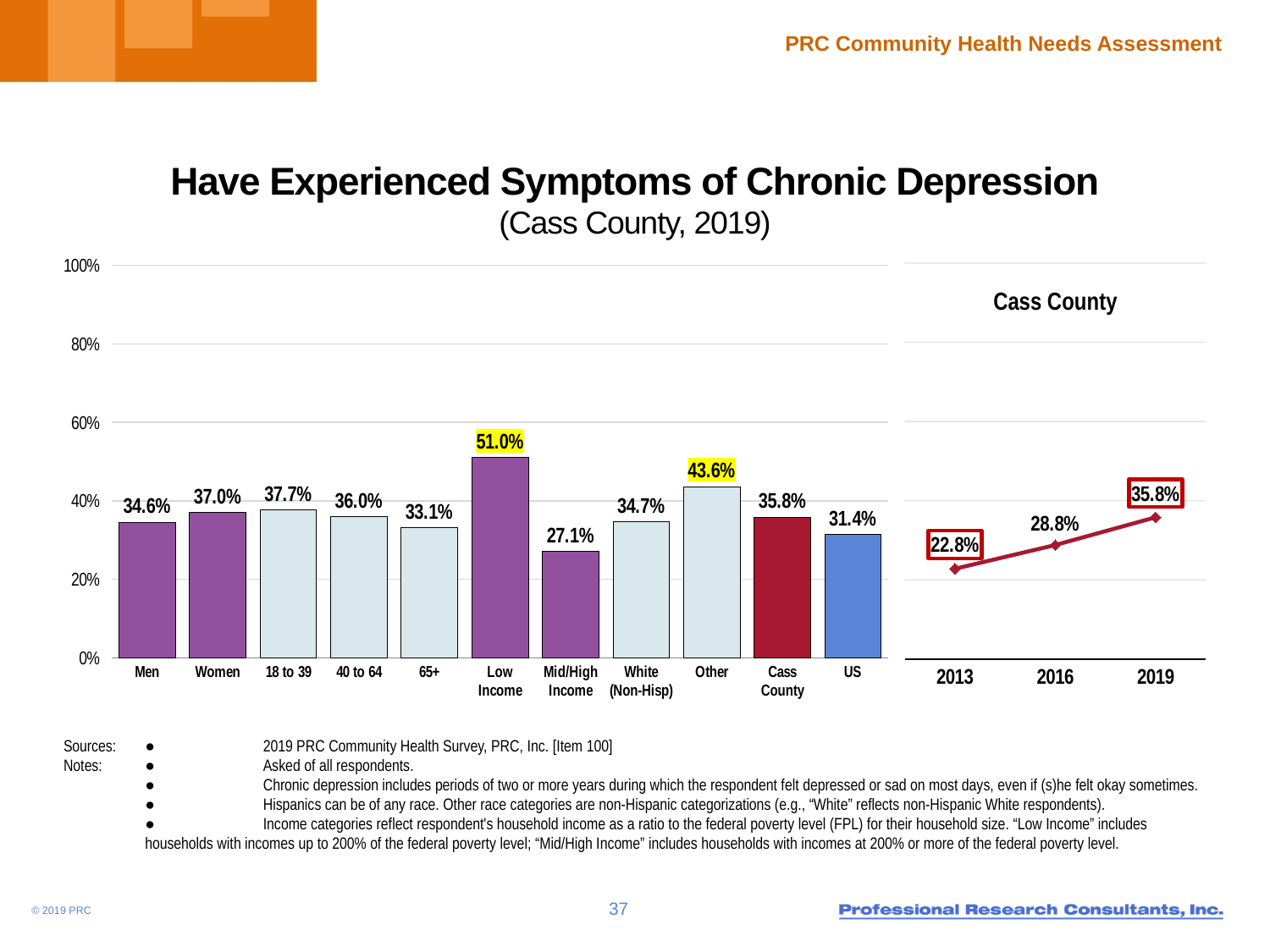
In the Cass County chart on the right, what is the value for 2013? 22.8% In the bar chart on the left, which category has the highest value? Low Income In the Cass County chart on the right, do the values rise or fall from 2013 to 2019? rise What kind of chart is the chart on the left? bar chart In the bar chart on the left, how many categories are shown? 11 In the Cass County chart on the right, what is the difference between the 2019 value and the 2013 value? 13.0% In the bar chart on the left, what is the value for Mid/High Income? 27.1% In the bar chart on the left, which category has the lowest value? Mid/High Income In the bar chart on the left, what is the value for Low Income? 51.0% In the bar chart on the left, which is larger, the value for Women or the value for Men? Women In the bar chart on the left, what is the difference between the Cass County value and the US value? 4.4% In the bar chart on the left, is the value for Other greater or less than 40%? greater